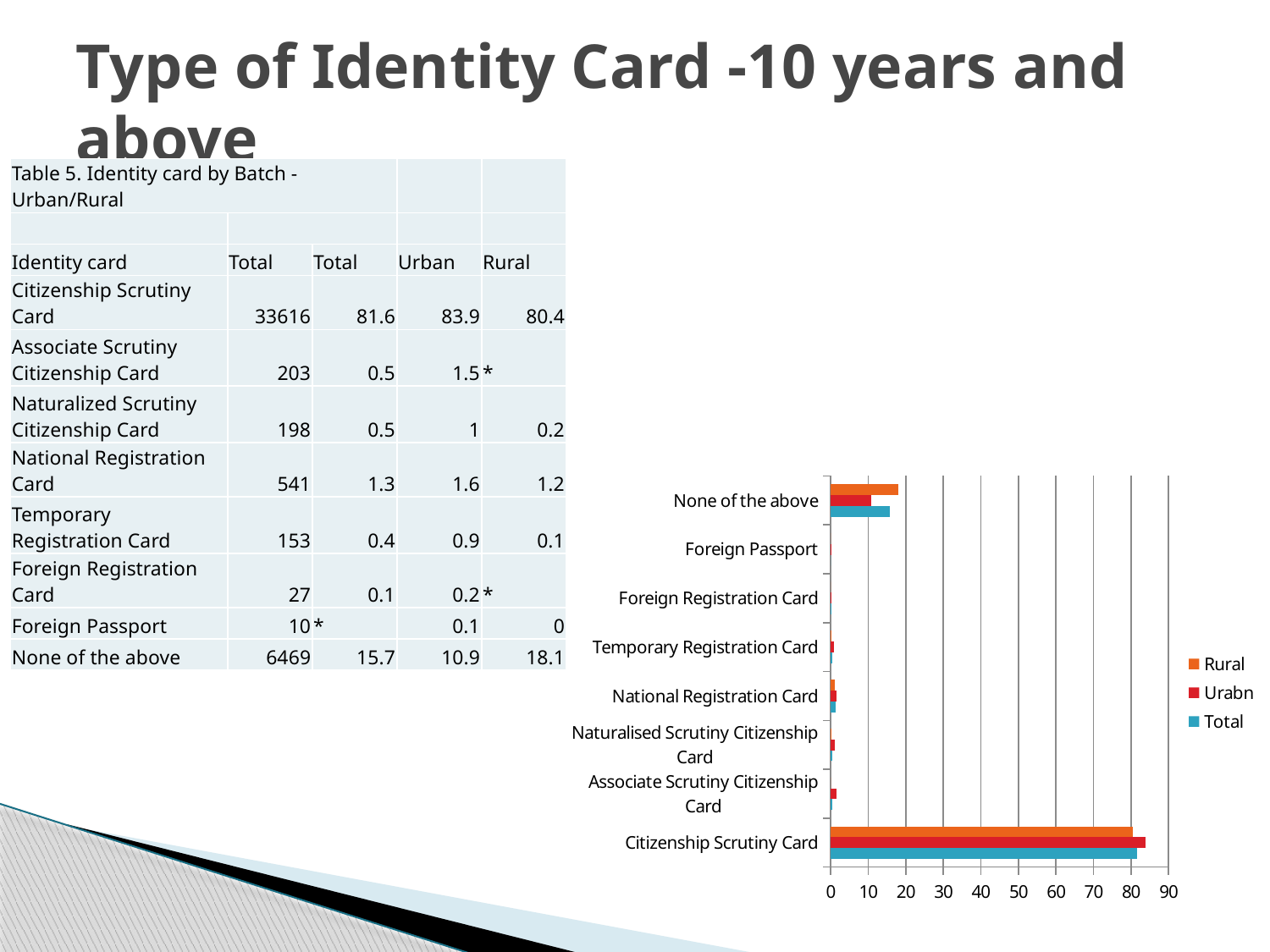
What are the three entries listed in the chart's legend? Rural, Urabn, Total What kind of chart is shown on the slide? bar chart For None of the above, which series has the larger value in the chart, Rural or Urabn? Rural How many series does the chart's legend list? 3 Which category has the highest Total value in the chart? Citizenship Scrutiny Card Is the Urabn value for None of the above in the chart greater or less than 20? less Which has the larger Total value in the chart, Citizenship Scrutiny Card or None of the above? Citizenship Scrutiny Card Is the Total value for Citizenship Scrutiny Card in the chart greater or less than 70? greater Is the Total value for Foreign Passport in the chart greater or less than 10? less What colour represents the Rural series in the chart? orange How many categories are plotted on the chart's vertical axis? 8